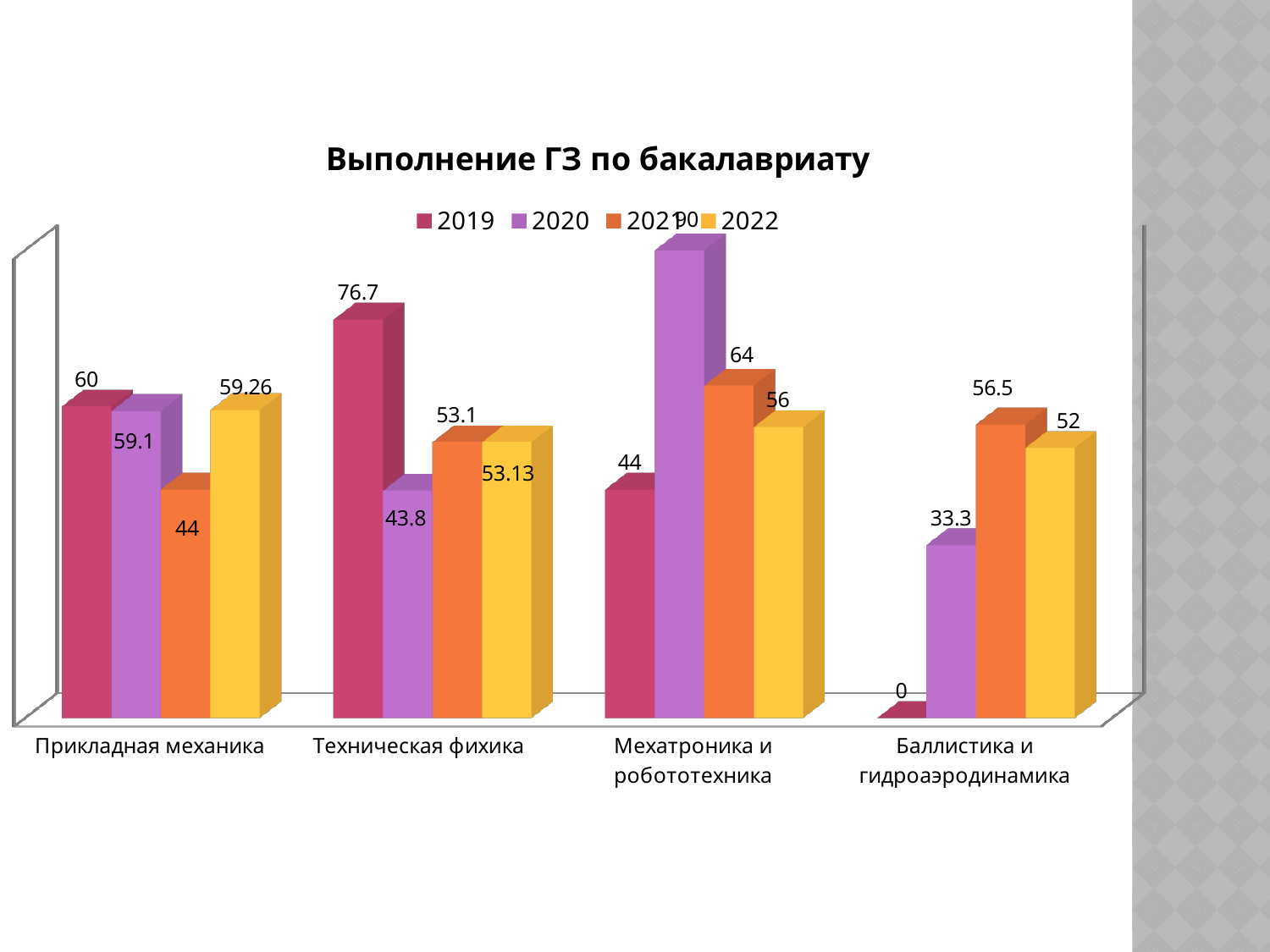
In the Мехатроника и робототехника category, what is the difference between the 2021 value and the 2022 value? 8 What is the value for 2021 in the Техническая фихика category? 53.1 In the Техническая фихика category, what is the difference between the 2019 value and the 2020 value? 32.9 What is the value for 2019 in the Баллистика и гидроаэродинамика category? 0 How many series does the legend list? 4 In the Прикладная механика category, which year has the lowest value? 2021 What is the value for 2019 in the Прикладная механика category? 60 What is the value for 2022 in the Баллистика и гидроаэродинамика category? 52 What kind of chart is shown on the slide? bar chart In the Техническая фихика category, which year has the highest value? 2019 How many categories are shown on the x axis? 4 In the Баллистика и гидроаэродинамика category, which is larger: the 2021 value or the 2022 value? 2021